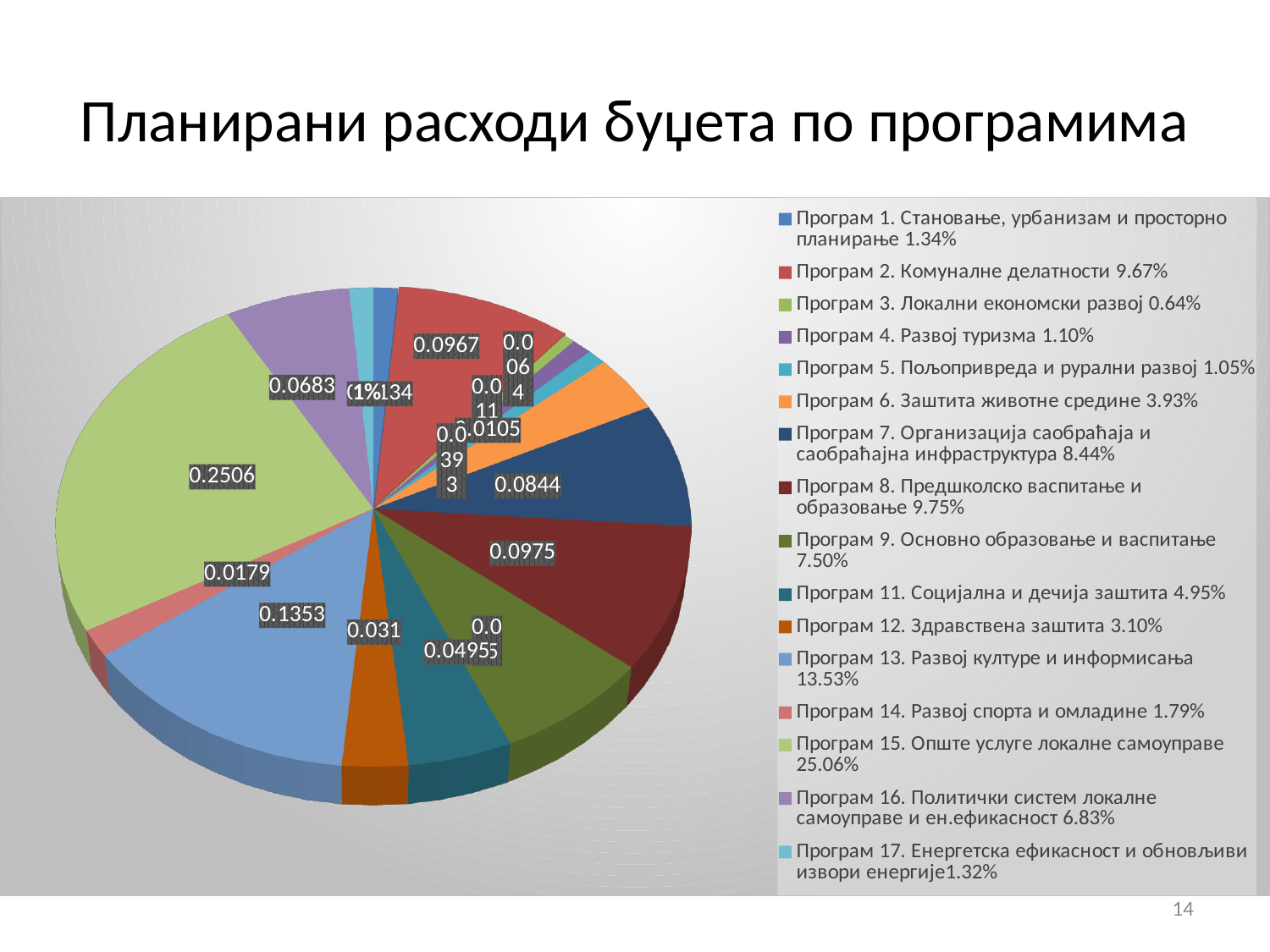
What share of the budget is planned for Програм 13. Развој културе и информисања, according to the legend? 13.53% What data label is shown on the slice for Програм 8. Предшколско васпитање и образовање? 0.0975 How many programs are listed in the chart's legend? 16 What data label is shown on the slice for Програм 2. Комуналне делатности? 0.0967 What is the title of the chart slide? Планирани расходи буџета по програмима What data label is shown on the slice for Програм 16. Политички систем локалне самоуправе и ен.ефикасност? 0.0683 Which program has the smallest share of the planned budget expenditures? Програм 3. Локални економски развој By how many percentage points does the share of Програм 15 (25.06%) exceed the share of Програм 13 (13.53%), using the legend values? 11.53 percentage points Which program has the largest share of the planned budget expenditures? Програм 15. Опште услуге локалне самоуправе What share of the budget is planned for Програм 15. Опште услуге локалне самоуправе, according to the legend? 25.06% What kind of chart is shown on the slide? Pie chart Which has a larger share of the budget: Програм 7. Организација саобраћаја и саобраћајна инфраструктура or Програм 11. Социјална и дечија заштита? Програм 7. Организација саобраћаја и саобраћајна инфраструктура